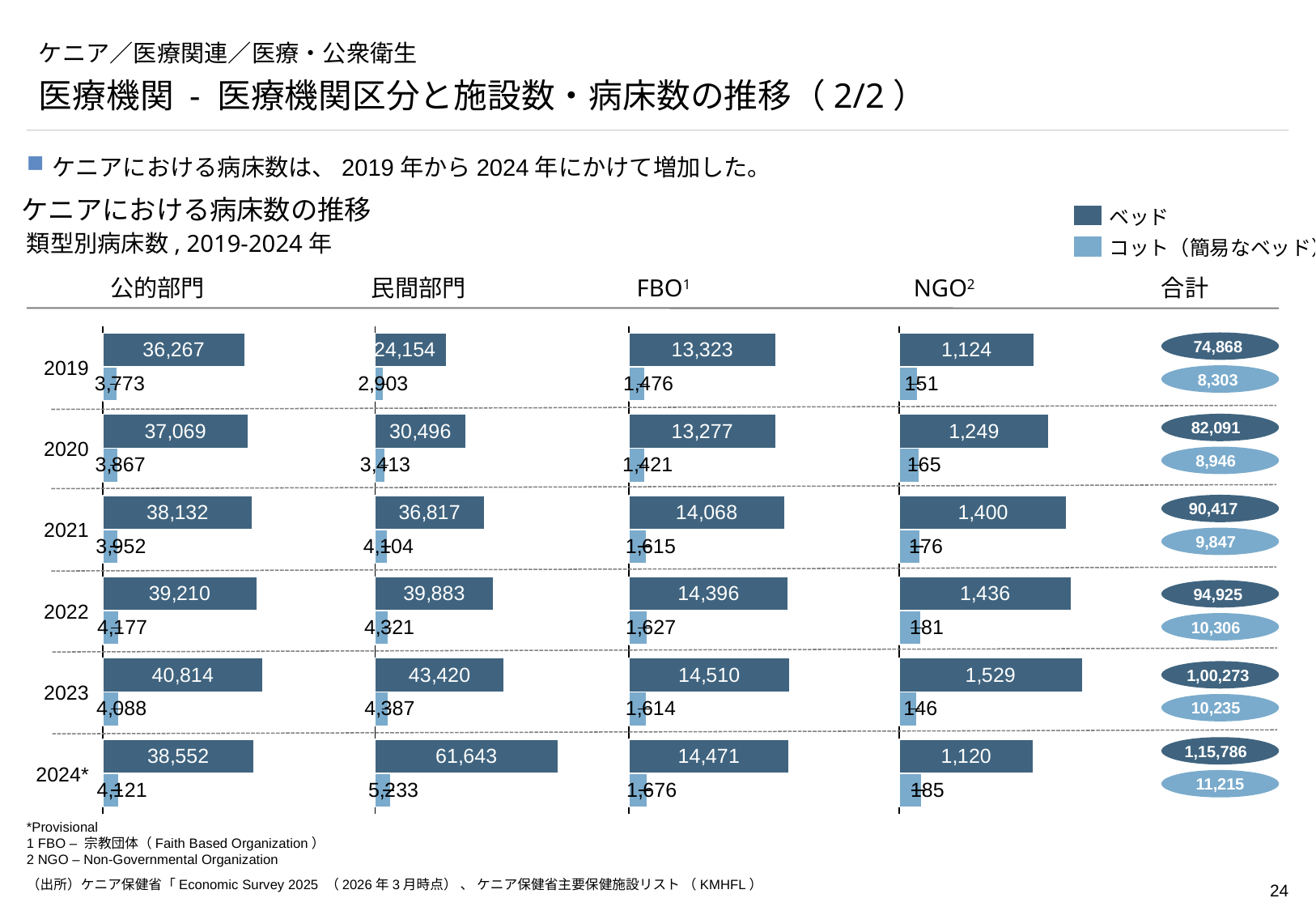
What is the number of ベッド (beds) in the NGO panel for 2023? 1,529 What is the 合計 (total) number of ベッド (beds) for 2024*? 1,15,786 What is the number of ベッド (beds) in the 公的部門 panel for 2019? 36,267 What kind of chart is shown on the slide? Bar chart What is the number of ベッド (beds) in the 民間部門 panel for 2024*? 61,643 In the NGO panel, which year has the lowest number of コット (cots)? 2023 How many series does the legend list? 2 For 2022, which has more ベッド (beds): 公的部門 or 民間部門? 民間部門 In the 民間部門 panel, which year has the highest number of ベッド (beds)? 2024* Does the 合計 (total) number of ベッド (beds) rise or fall from 2019 to 2024*? Rise In the 公的部門 panel, what is the difference in ベッド (beds) between 2023 and 2019? 4,547 What is the number of コット (cots) in the FBO panel for 2021? 1,615